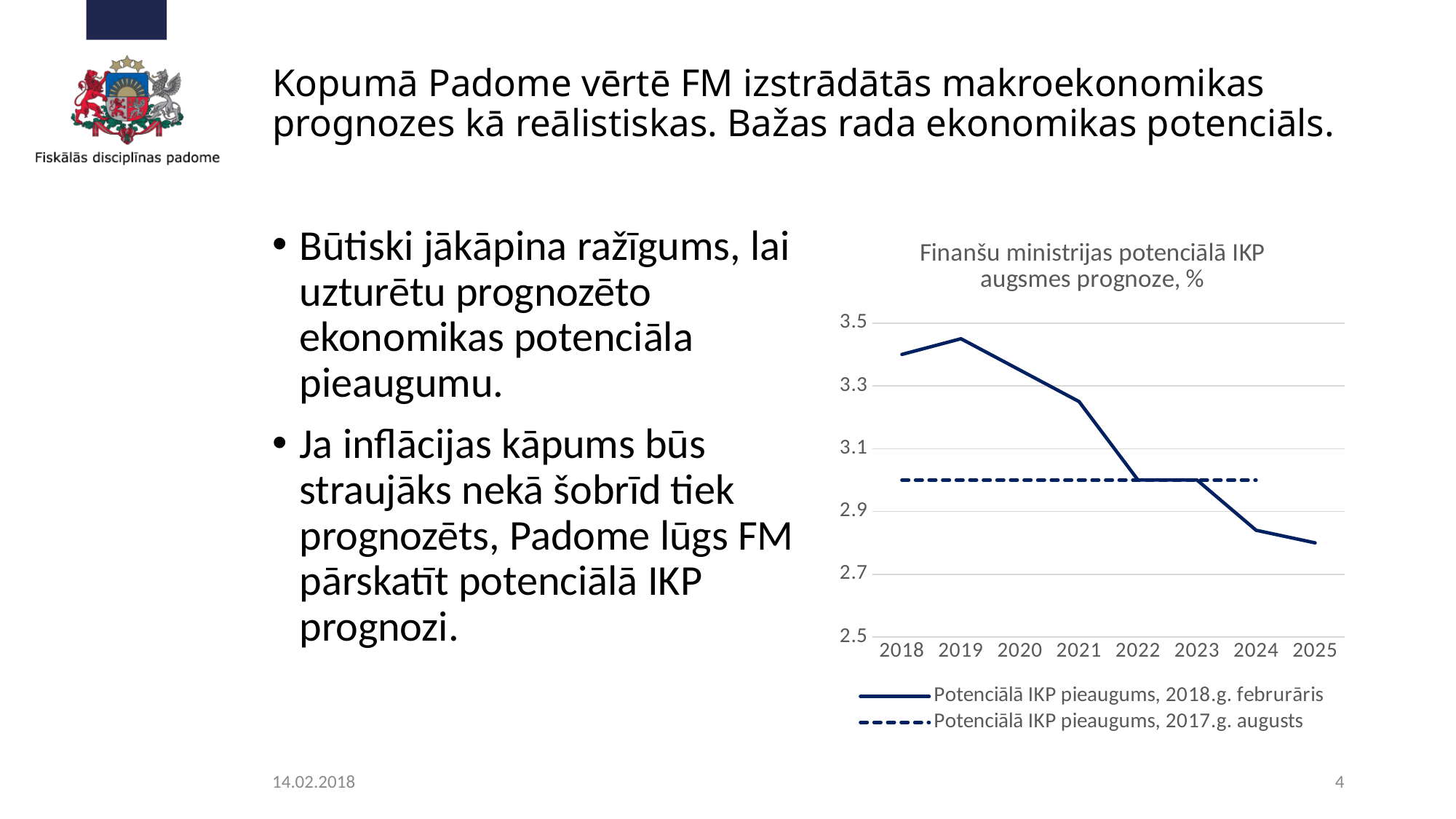
Is the value of the series 'Potenciālā IKP pieaugums, 2017.g. augusts' greater or less than 3.1? less What kind of chart is shown on the slide? line chart How many years are shown on the x axis of the chart? 8 Is the value for 2022 in the series 'Potenciālā IKP pieaugums, 2018.g. februāris' greater or less than 3.1? less What is the title of the chart? Finanšu ministrijas potenciālā IKP augsmes prognoze, % Is the value for 2018 in the series 'Potenciālā IKP pieaugums, 2018.g. februāris' greater or less than 3.3? greater How many series does the chart legend list? 2 In 2018, which series has the higher value: 'Potenciālā IKP pieaugums, 2018.g. februāris' or 'Potenciālā IKP pieaugums, 2017.g. augusts'? Potenciālā IKP pieaugums, 2018.g. februāris Does the series 'Potenciālā IKP pieaugums, 2018.g. februāris' generally rise or fall from 2019 to 2025? fall In which year does the series 'Potenciālā IKP pieaugums, 2018.g. februāris' reach its highest value? 2019 In which year does the series 'Potenciālā IKP pieaugums, 2018.g. februāris' reach its lowest value? 2025